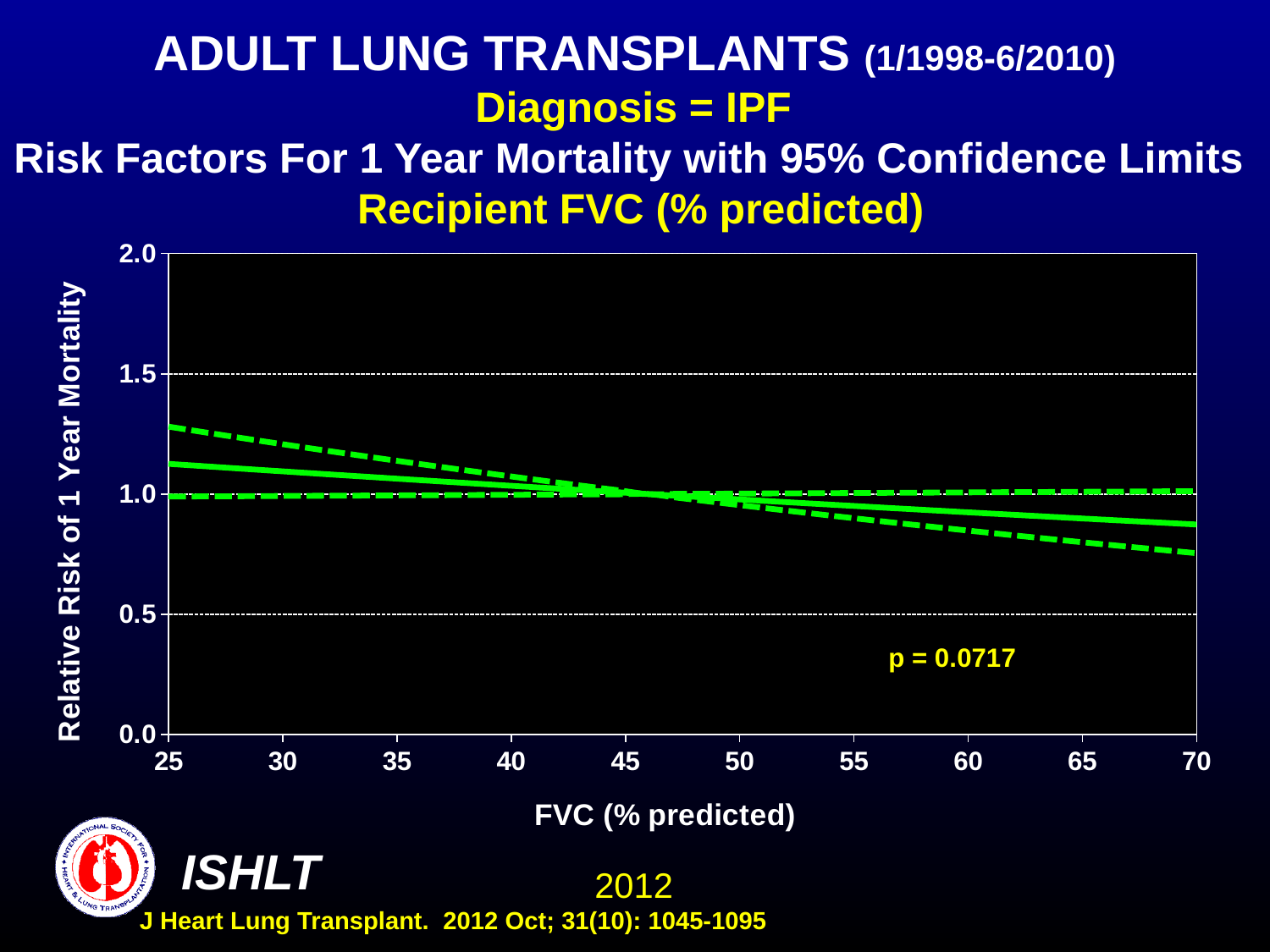
Is the relative risk of 1 year mortality (solid line) at FVC 25% predicted greater or less than 1.5? less Does the relative risk of 1 year mortality (solid line) rise or fall as recipient FVC (% predicted) increases from 25 to 70? fall Is the relative risk of 1 year mortality (solid line) higher at FVC 25% predicted or at FVC 70% predicted? FVC 25% predicted Is the upper 95% confidence limit (upper dashed line) at FVC 25% predicted greater or less than 1.0? greater What kind of chart is shown on the slide? line chart Is the relative risk of 1 year mortality (solid line) at FVC 25% predicted greater or less than 1.0? greater What p-value is printed on the chart? p = 0.0717 What is the label of the x axis of the chart? FVC (% predicted) How many lines are plotted on the chart? 3